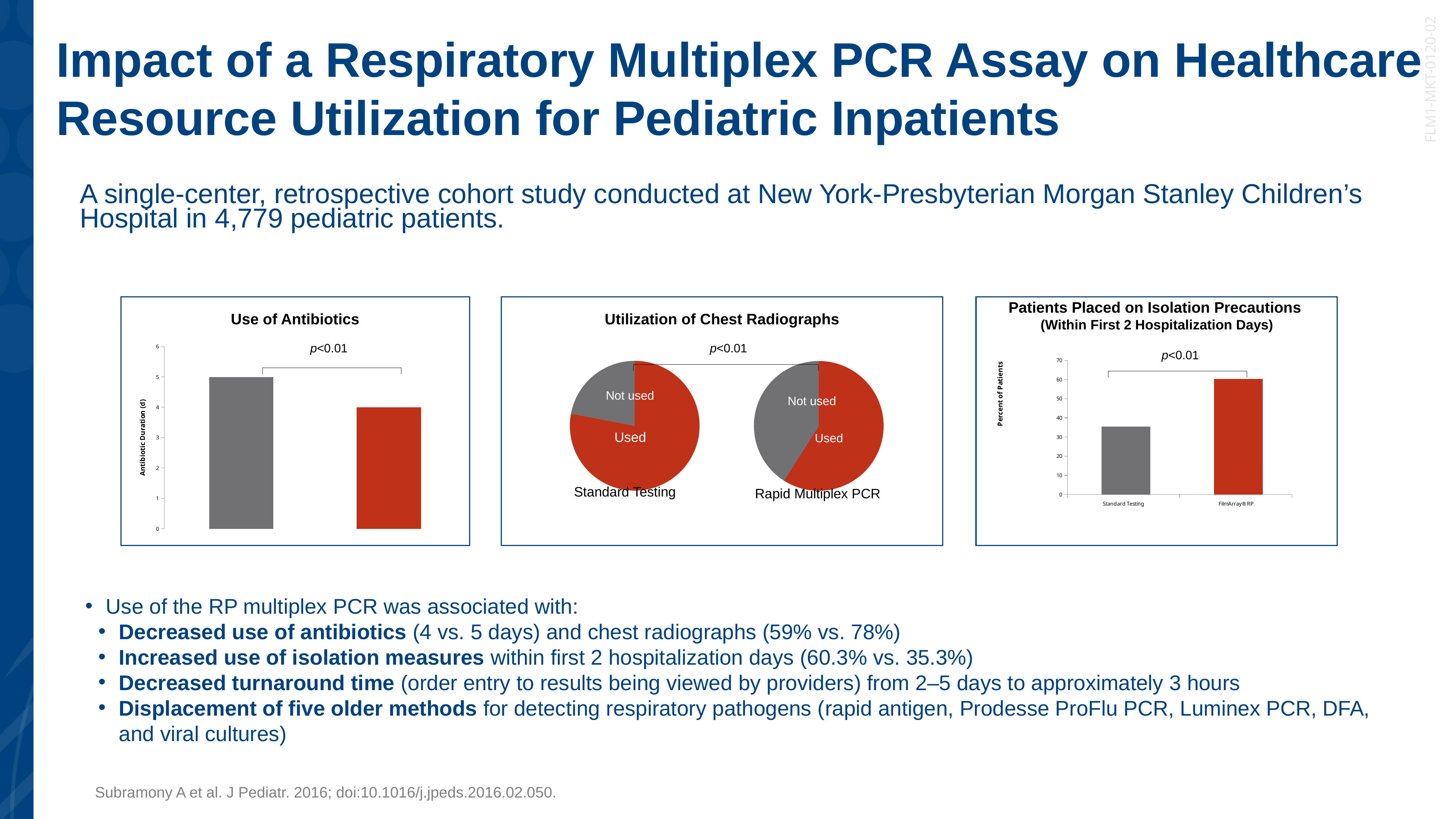
In the "Use of Antibiotics" chart, what value does the gray bar reach on the Antibiotic Duration (d) axis? 5 In the "Utilization of Chest Radiographs" panel, which pie has the larger "Used" slice, Standard Testing or Rapid Multiplex PCR? Standard Testing In the "Use of Antibiotics" chart, what is the difference between the gray bar and the red bar? 1 What kind of chart is used in the "Utilization of Chest Radiographs" panel? pie chart In the "Patients Placed on Isolation Precautions" chart, is the value for Standard Testing greater or less than 40? less In the "Use of Antibiotics" chart, which bar is taller, the gray bar or the red bar? the gray bar In the "Utilization of Chest Radiographs" panel, what are the two slice labels shown in each pie? Used and Not used In the "Use of Antibiotics" chart, what value does the red bar reach on the Antibiotic Duration (d) axis? 4 How many bars are plotted in the "Use of Antibiotics" chart? 2 What kind of chart is the "Use of Antibiotics" chart? bar chart In the "Patients Placed on Isolation Precautions" chart, which category has the highest value? FilmArray® RP In the "Patients Placed on Isolation Precautions" chart, is the value for FilmArray® RP greater or less than 50? greater